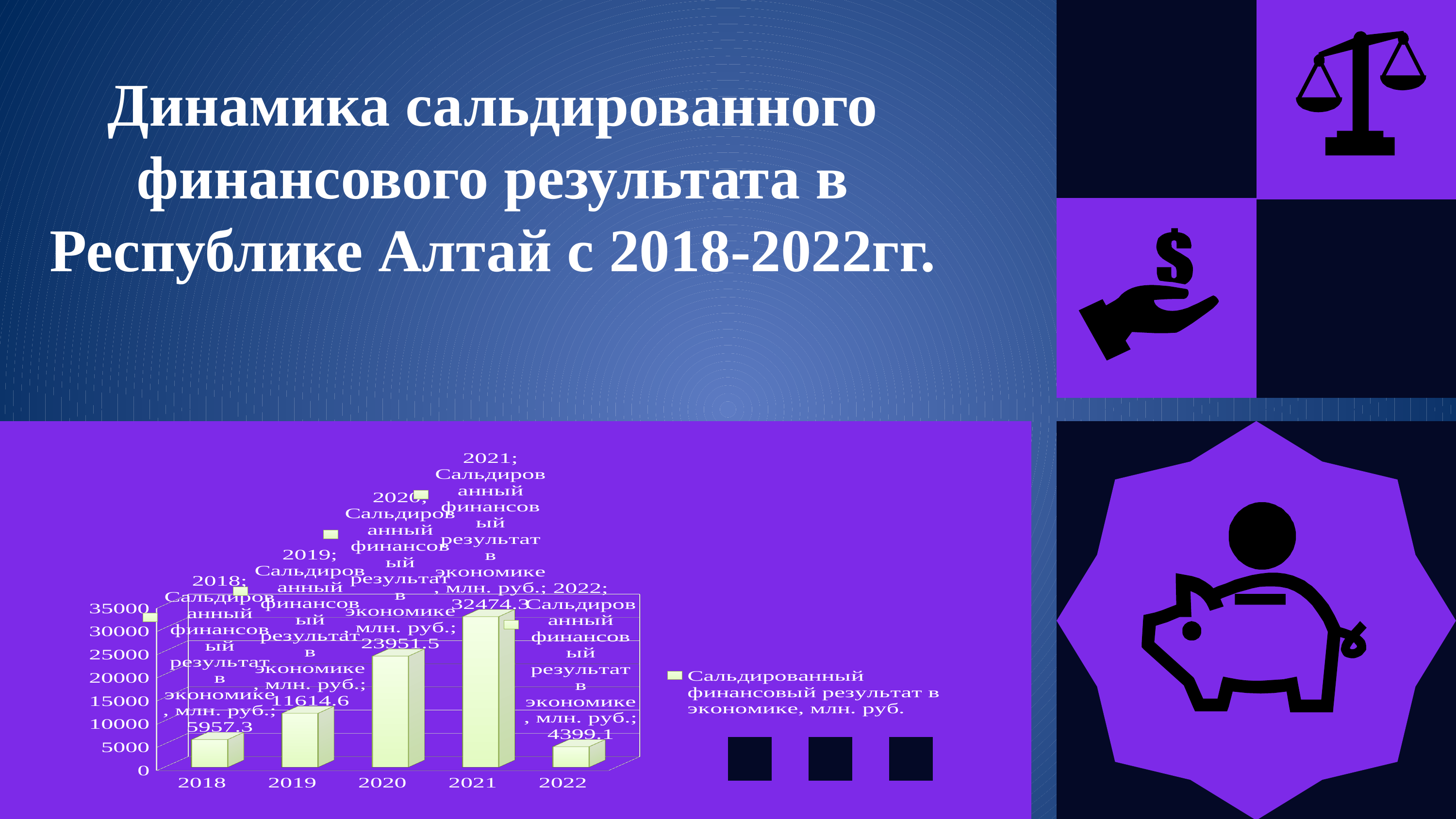
What is the value for 2020? 23951.5 Which year has the highest value? 2021 Which is larger, the value for 2019 or the value for 2022? 2019 Which year has the lowest value? 2022 What is the difference between the values for 2021 and 2020? 8522.8 How many years are shown on the x axis? 5 What is the value for 2018? 5957.3 What kind of chart is shown on the slide? bar chart What series name does the legend list? Сальдированный финансовый результат в экономике, млн. руб. What is the value for 2019? 11614.6 What is the value for 2021? 32474.3 What is the value for 2022? 4399.1